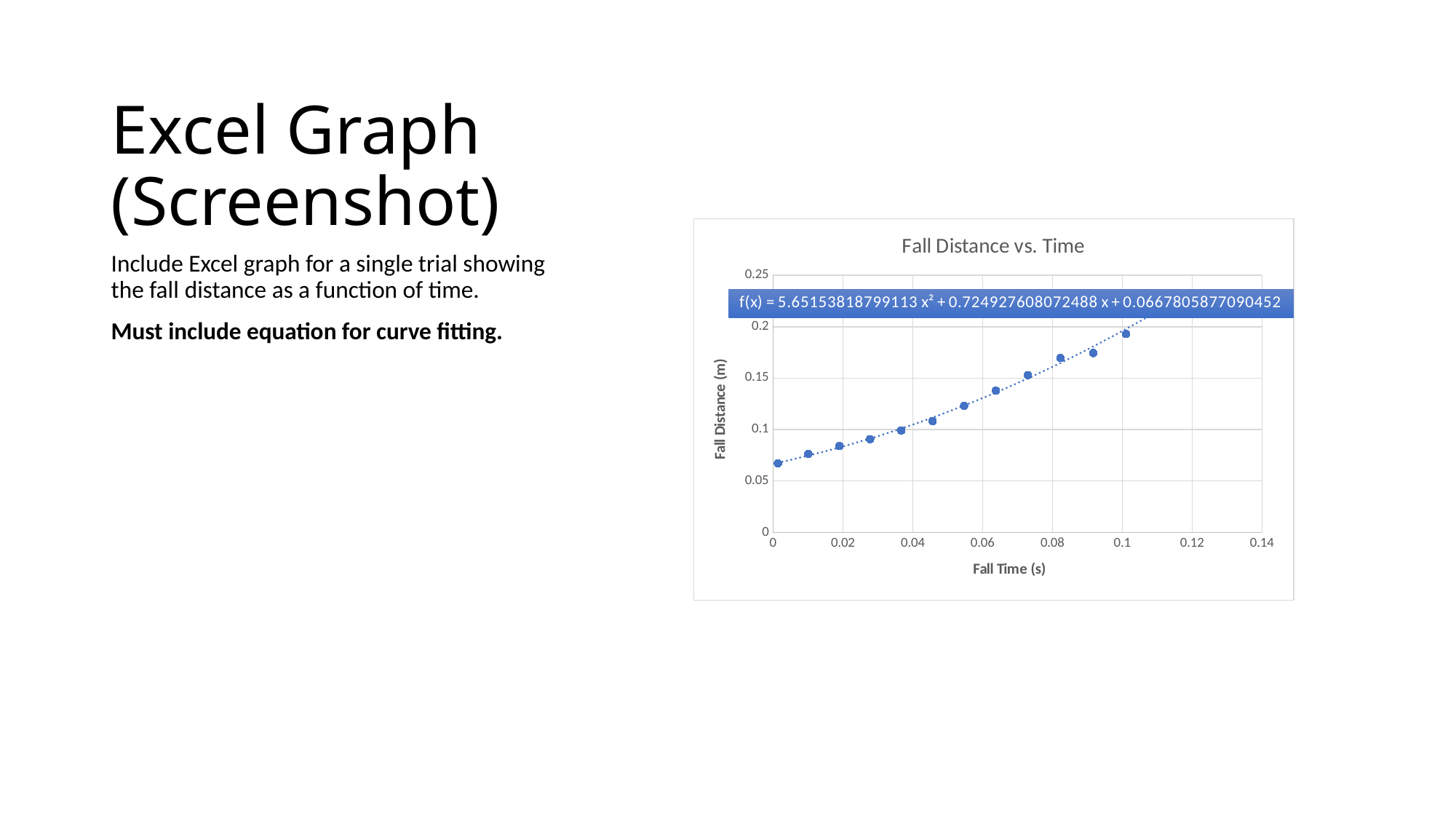
Is the fall distance for the leftmost point (at fall time 0) greater or less than 0.1? less Does fall distance rise or fall as fall time increases along the x axis? Rises Is the fall distance for the point at fall time 0.02 s greater or less than 0.1? less Is the fall distance for the point at fall time 0.08 s greater or less than 0.15? greater What kind of chart is shown on the slide? Scatter chart Which has the larger fall distance: the point at fall time 0.1 s or the point at fall time 0.02 s? The point at fall time 0.1 s Which plotted point has the lowest fall distance? The leftmost point (at fall time 0) According to the fitted equation shown on the chart, what is the coefficient of x²? 5.65153818799113 What is the title of the chart? Fall Distance vs. Time